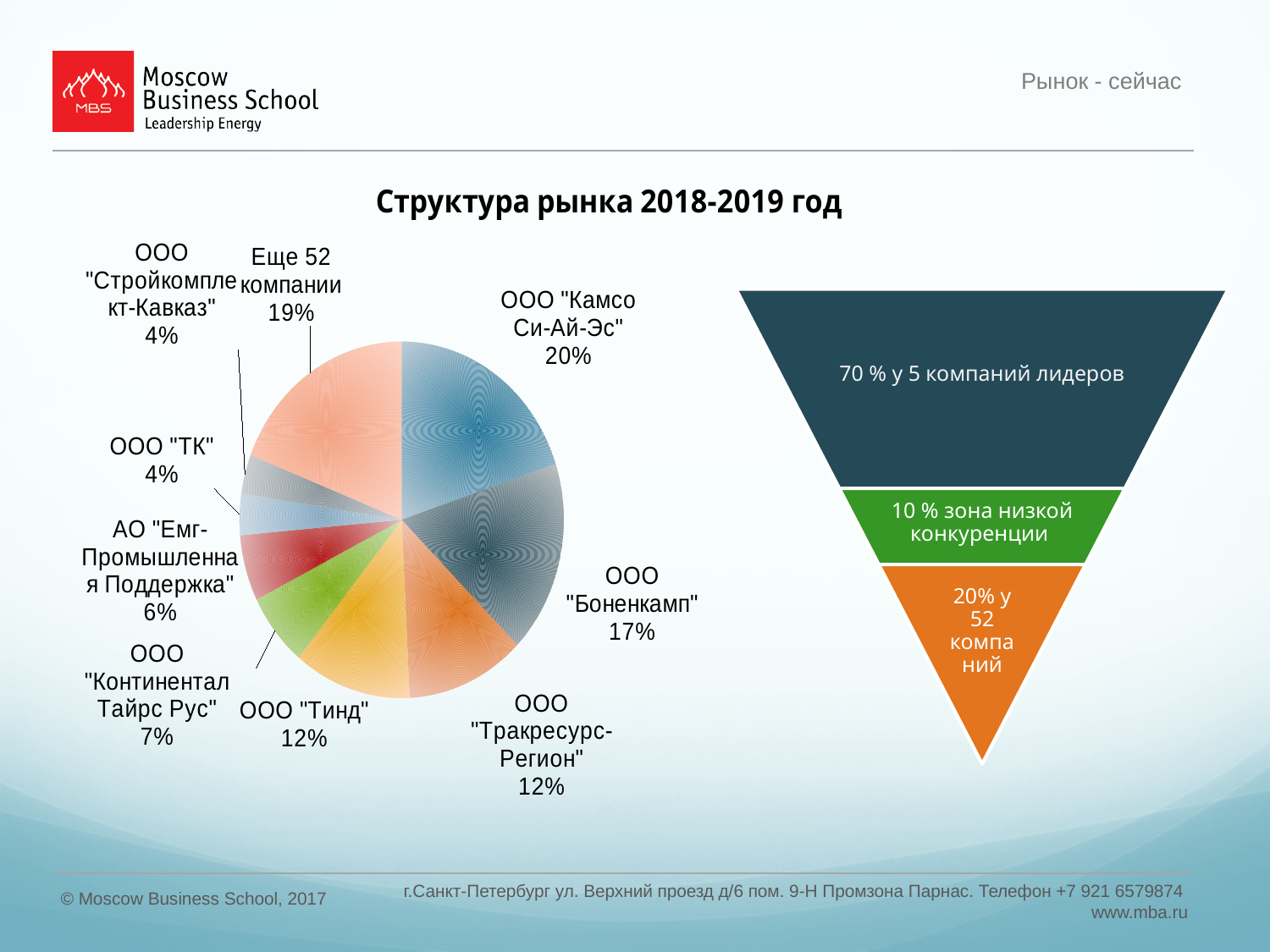
What share of the market does ООО "Камсо Си-Ай-Эс" hold in the pie chart? 20% What is the difference between the shares of ООО "Тинд" and ООО "ТК"? 8% What share does ООО "Континентал Тайрс Рус" have in the pie chart? 7% What is the title of the chart on the slide? Структура рынка 2018-2019 год What is the value for АО "Емг-Промышленная Поддержка" in the pie chart? 6% Which named company has the largest slice in the pie chart? ООО "Камсо Си-Ай-Эс" What type of chart is shown on the slide? Pie chart Which has a larger share: АО "Емг-Промышленная Поддержка" or ООО "Континентал Тайрс Рус"? ООО "Континентал Тайрс Рус" What percentage is shown for ООО "Тинд"? 12% How many slices does the pie chart have? 9 What is the value shown for ООО "Боненкамп" in the pie chart? 17% What is the difference in percentage points between ООО "Камсо Си-Ай-Эс" and ООО "Боненкамп"? 3%